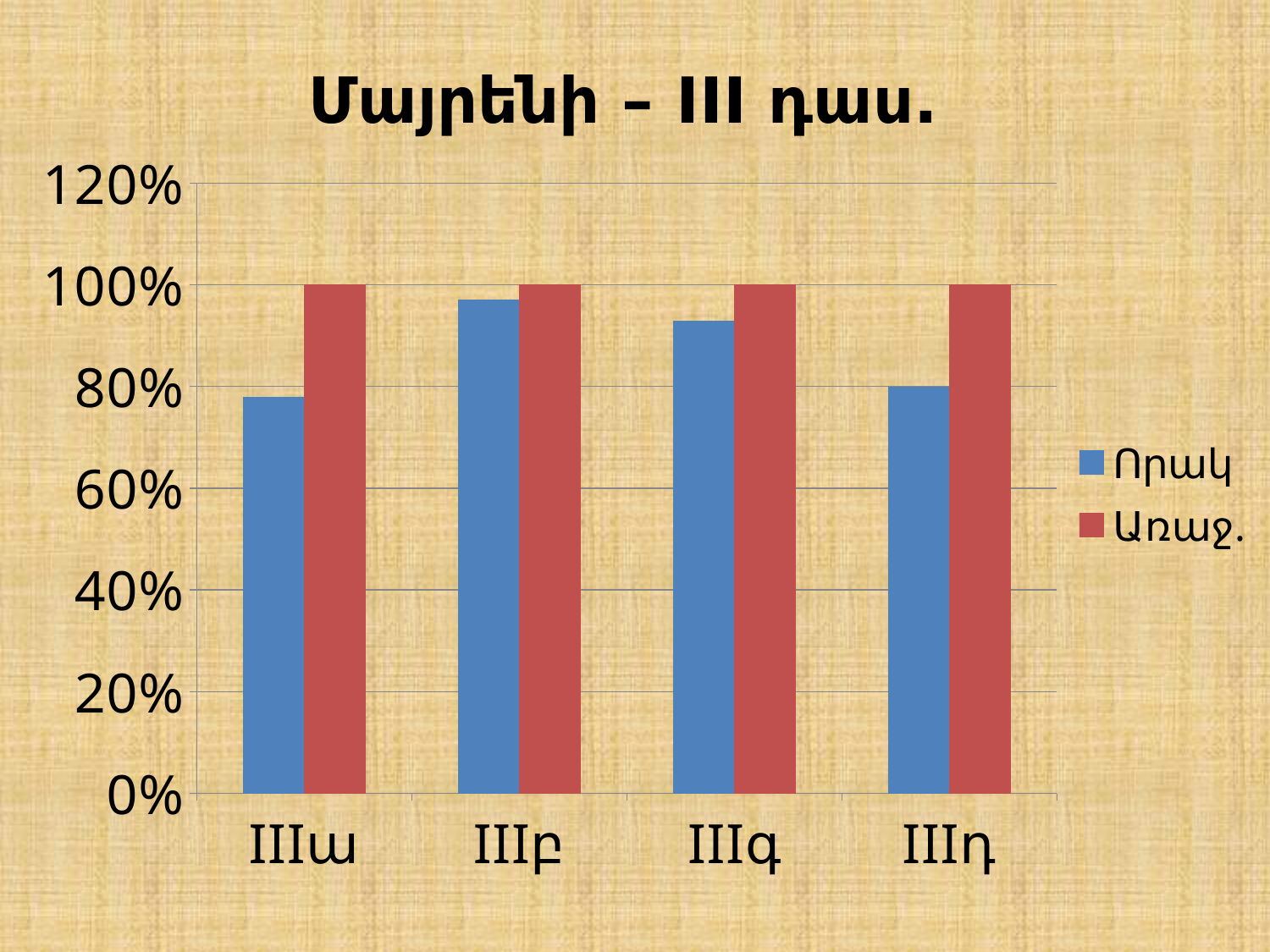
Which is larger, the Որակ value for IIIբ or for IIIգ? IIIբ What kind of chart is shown on the slide? bar chart How many categories are shown on the x axis? 4 How many series does the legend list? 2 For IIIա, which series has the larger value, Որակ or Առաջ.? Առաջ. Which category has the highest Որակ value? IIIբ Which category has the lowest Որակ value? IIIա What is the title of the chart? Մայրենի - III դաս. Is the Որակ value for IIIբ greater or less than 80%? greater Is the Որակ value for IIIա greater or less than 80%? less What is the value of Առաջ. for IIIա? 100% What is the value of Առաջ. for IIIդ? 100%